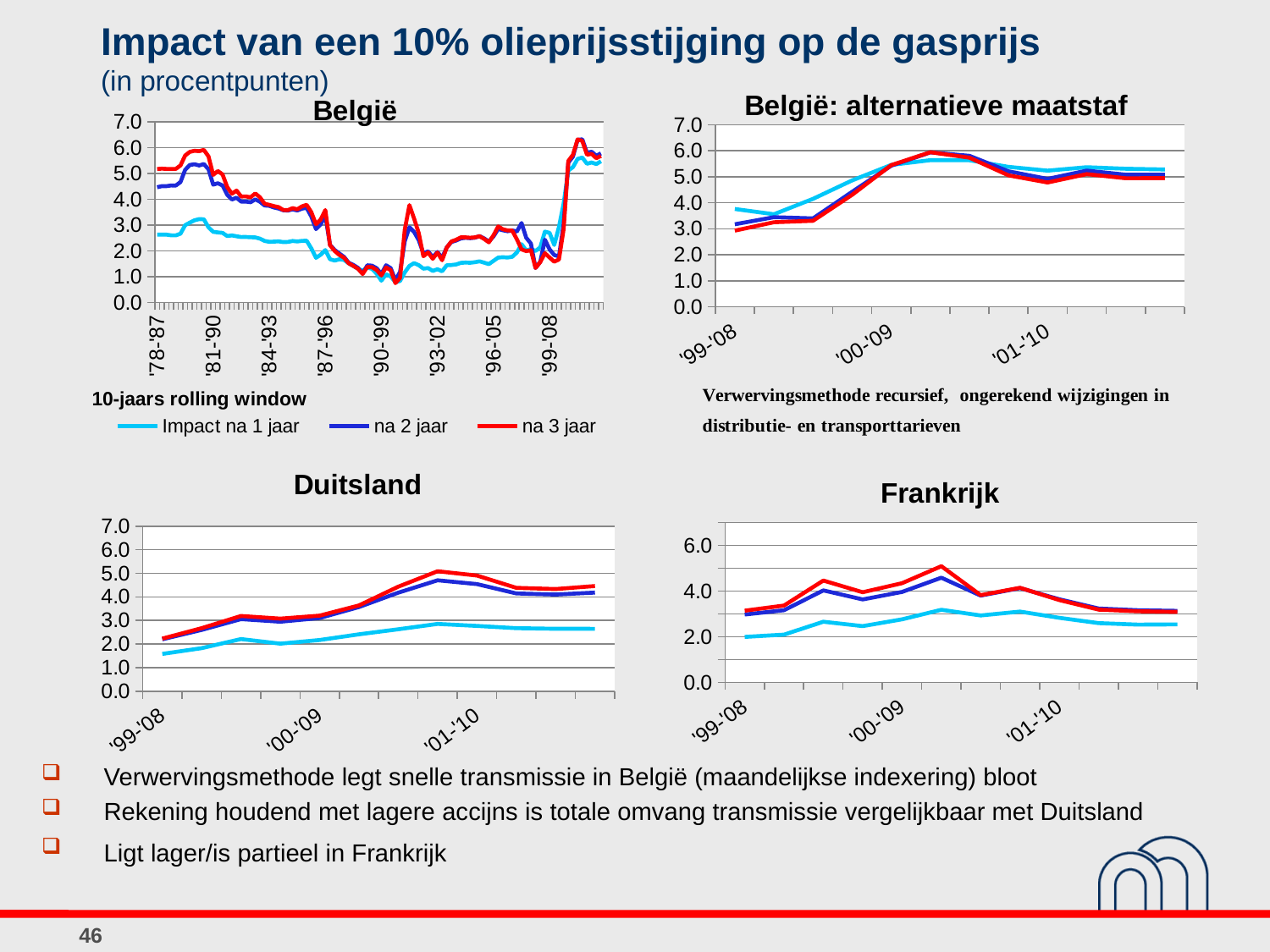
In the 'België' chart, at '78-'87, which is larger: 'na 3 jaar' or 'na 2 jaar'? na 3 jaar What is the title of the chart at the top right of the slide? België: alternatieve maatstaf In the 'Duitsland' chart, is the value for 'Impact na 1 jaar' at '99-'08 greater or less than 2.0? less In the 'België' chart, is the value for 'Impact na 1 jaar' at '78-'87 greater or less than 4.0? less How many series does the legend under the 'België' chart list? 3 In the 'Frankrijk' chart, which series reaches the highest value? na 3 jaar In the 'Frankrijk' chart, is the value for 'na 3 jaar' at '99-'08 greater or less than 2.0? greater What kind of chart is the 'België' chart at the top left of the slide? Line chart What are the three series named in the legend under the 'België' chart? Impact na 1 jaar, na 2 jaar, na 3 jaar In the 'Duitsland' chart, does the 'na 3 jaar' line rise or fall from '99-'08 to '01-'10? rise In the 'Duitsland' chart, at '99-'08, which is larger: 'na 3 jaar' or 'Impact na 1 jaar'? na 3 jaar